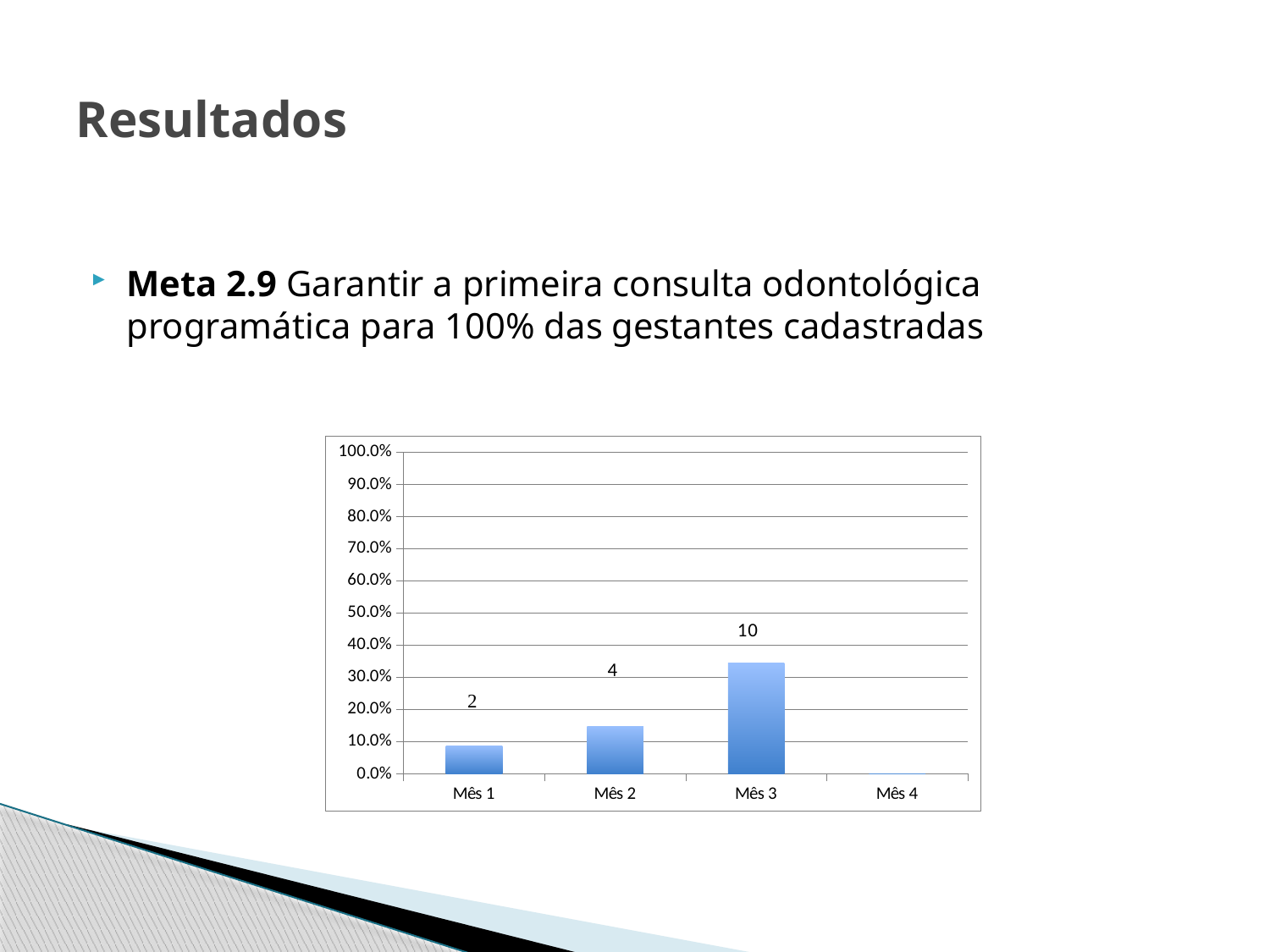
Is the value for Mês 2 greater or less than 10.0%? greater What is the data label shown on the bar for Mês 3? 10 What is the data label shown on the bar for Mês 1? 2 What kind of chart is shown on the slide? Bar chart How many months are shown on the x axis of the chart? 4 Do the bars rise or fall from Mês 1 to Mês 3? Rise Which bar is taller, Mês 1 or Mês 2? Mês 2 Is the value for Mês 3 greater or less than 30.0%? greater What is the data label shown on the bar for Mês 2? 4 Which month has the lowest bar in the chart? Mês 4 What is the difference between the data labels for Mês 3 and Mês 2? 6 Which month has the highest bar in the chart? Mês 3